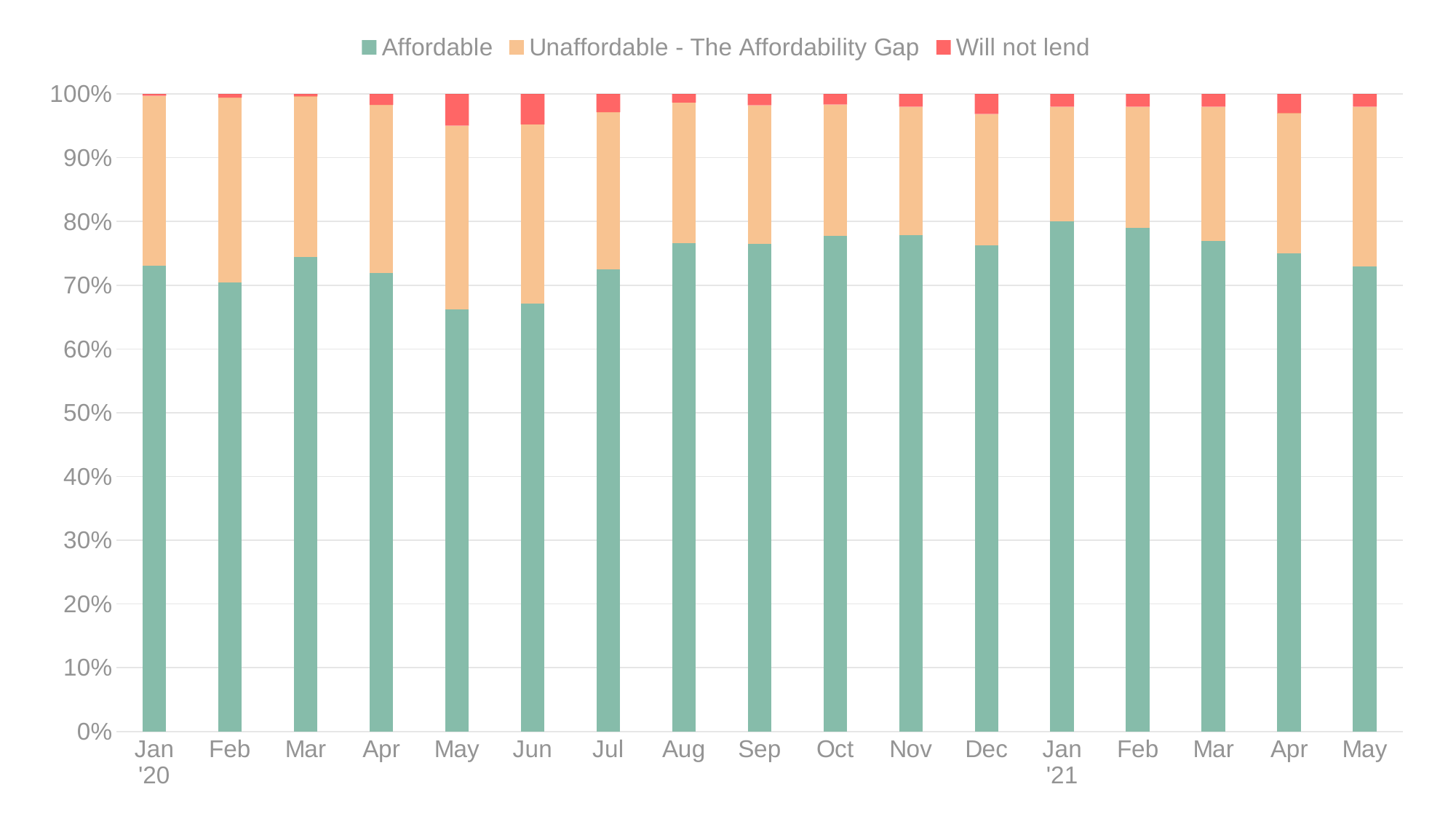
Is the Affordable value for Nov '20 greater or less than 80%? less Is the Affordable value for May '20 greater or less than 70%? less Which has the larger Affordable share, May '20 or Jan '21? Jan '21 Which has the larger Affordable share, Feb '20 or Mar '20? Mar '20 Which month has the highest Affordable share? Jan '21 Which series is shown in red? Will not lend Is the Affordable value for Jan '20 greater or less than 70%? greater What kind of chart is shown on the slide? Stacked bar chart Which month has the lowest Affordable share? May '20 What is the total of the stacked bar for Jan '20? 100% How many series does the legend list? 3 How many months are shown along the x axis? 17